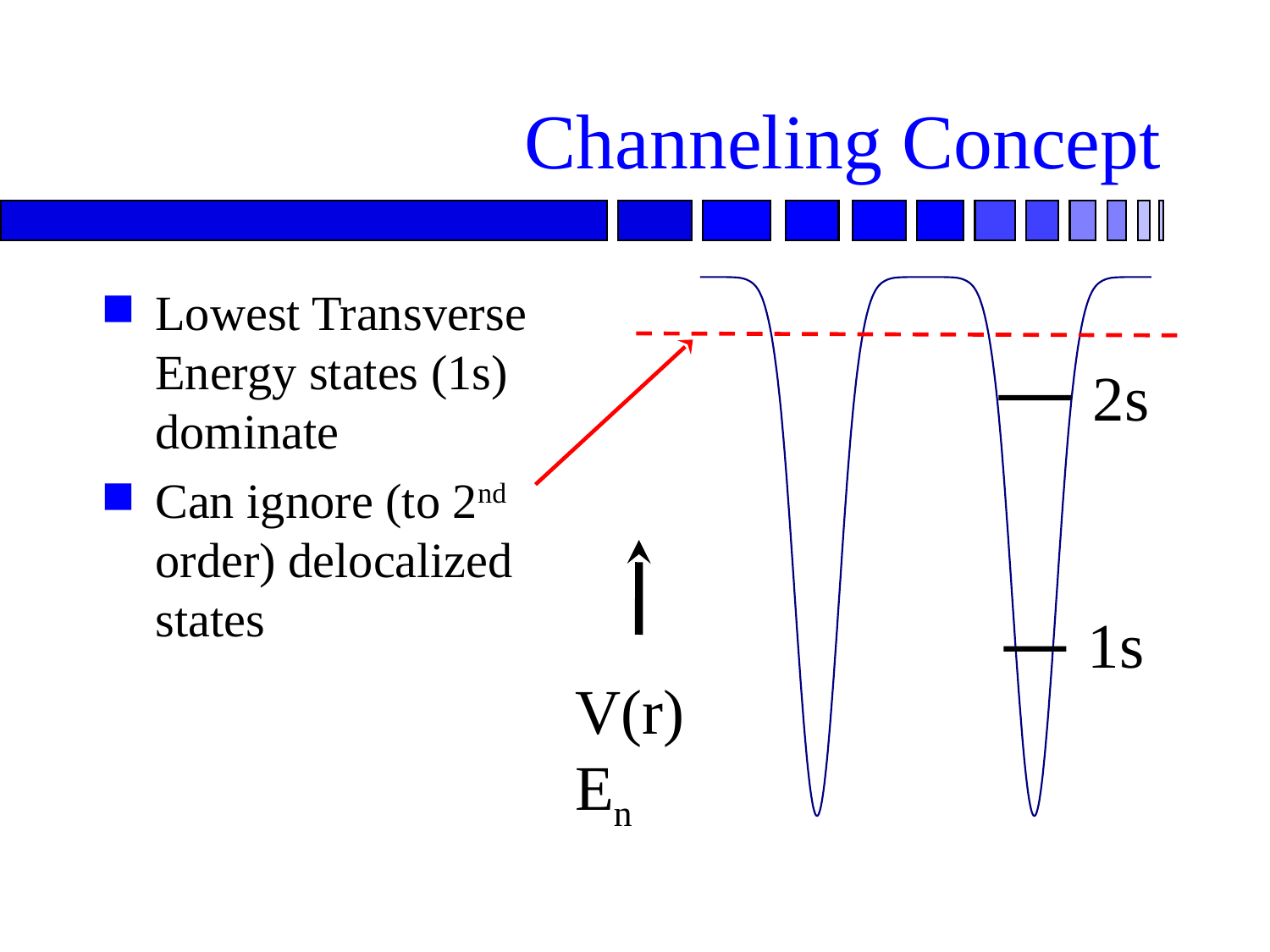
What quantities label the vertical axis of the diagram? V(r) and En How many energy levels are labelled in the diagram? 2 Which energy level is drawn lowest in the potential well? 1s Which energy level is drawn higher in the well, 1s or 2s? 2s What is the title of the slide containing the potential-well diagram? Channeling Concept How many potential wells are drawn in the V(r) diagram? 2